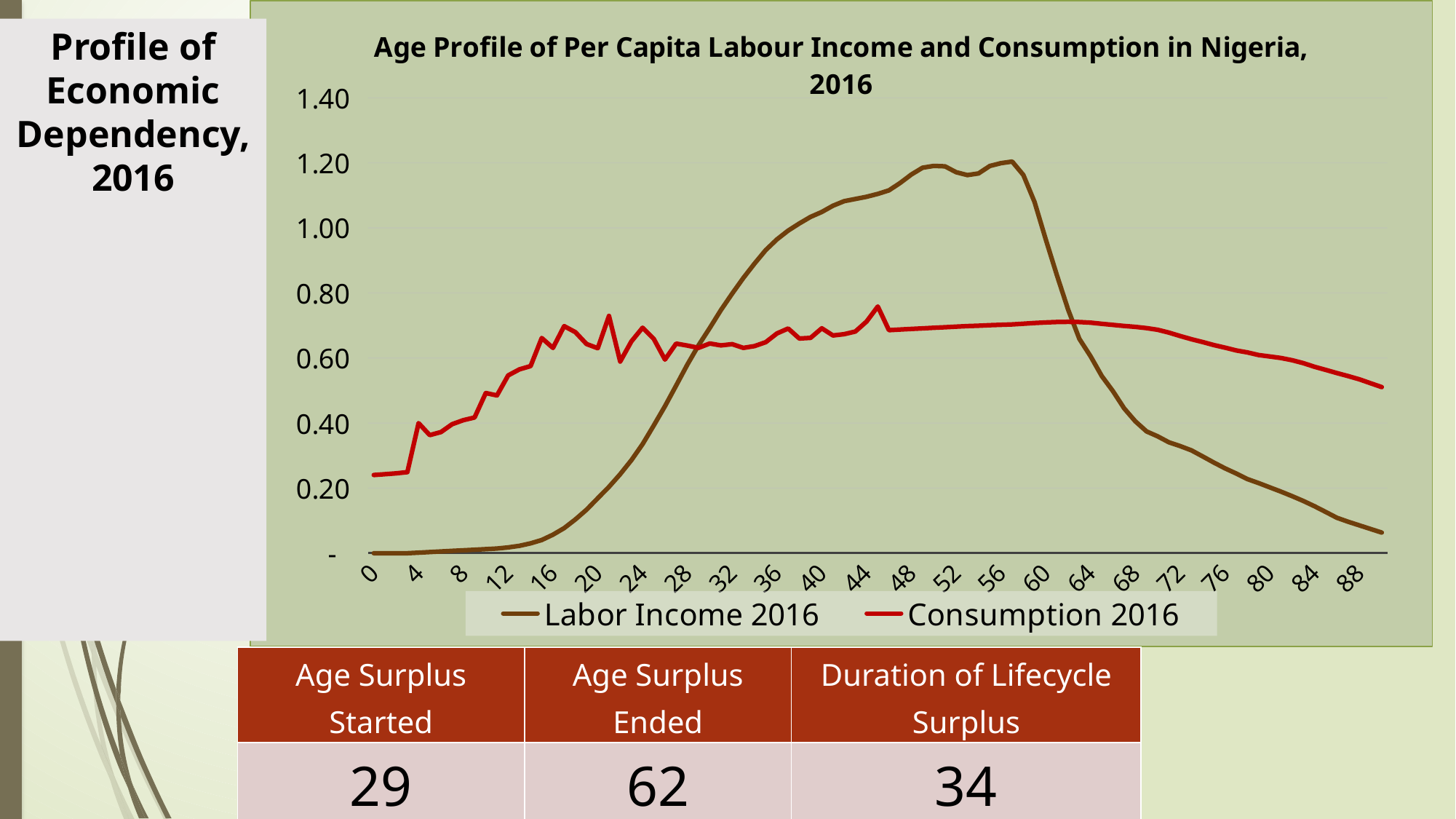
Is the value of Labor Income 2016 at age 0 greater or less than 0.20? less What are the two series named in the chart legend? Labor Income 2016 and Consumption 2016 Is the value of Labor Income 2016 at age 56 greater or less than 1.00? greater At age 20, which series has the higher value, Labor Income 2016 or Consumption 2016? Consumption 2016 Is the value of Consumption 2016 at age 0 greater or less than 0.40? less What kind of chart is shown on the slide? line chart Which series reaches the higher peak value on the chart? Labor Income 2016 Does the Labor Income 2016 line rise or fall between age 64 and age 88? fall How many series does the chart legend list? 2 At age 48, which series has the higher value, Labor Income 2016 or Consumption 2016? Labor Income 2016 What is the title of the chart? Age Profile of Per Capita Labour Income and Consumption in Nigeria, 2016